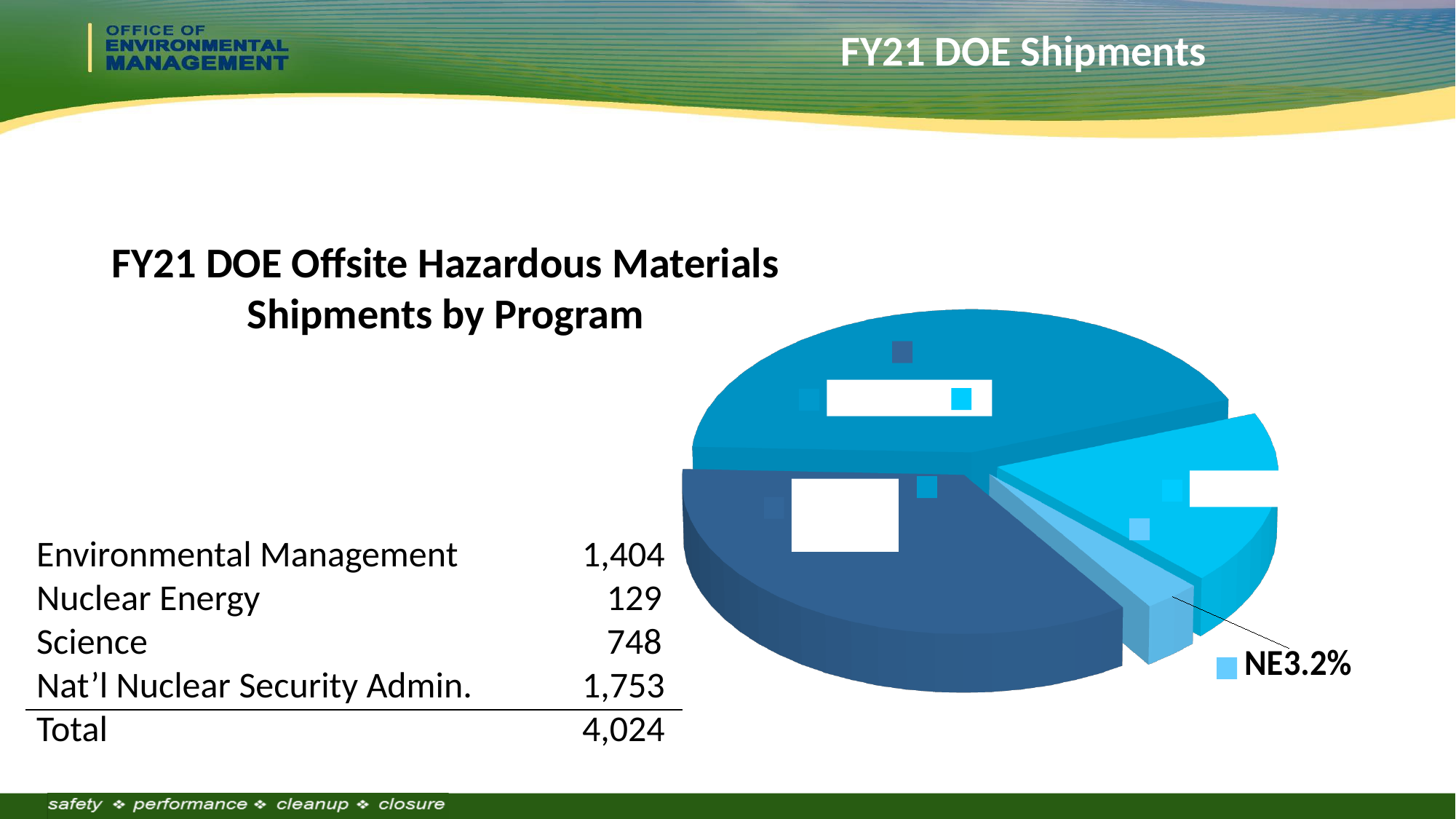
Which program has the lowest number of shipments? Nuclear Energy What is the difference in shipments between Nat'l Nuclear Security Admin. and Environmental Management? 349 What kind of chart is shown on the slide? pie chart How many shipments are listed for Environmental Management? 1,404 How many shipments are listed for Nuclear Energy? 129 Which program has the highest number of shipments? Nat'l Nuclear Security Admin. How many shipments are listed for Science? 748 What percentage share is labelled for NE on the pie chart? 3.2% How many programs are listed in the shipments breakdown? 4 What is the total number of shipments across all programs? 4,024 How many shipments are listed for Nat'l Nuclear Security Admin.? 1,753 What is the chart's title? FY21 DOE Offsite Hazardous Materials Shipments by Program